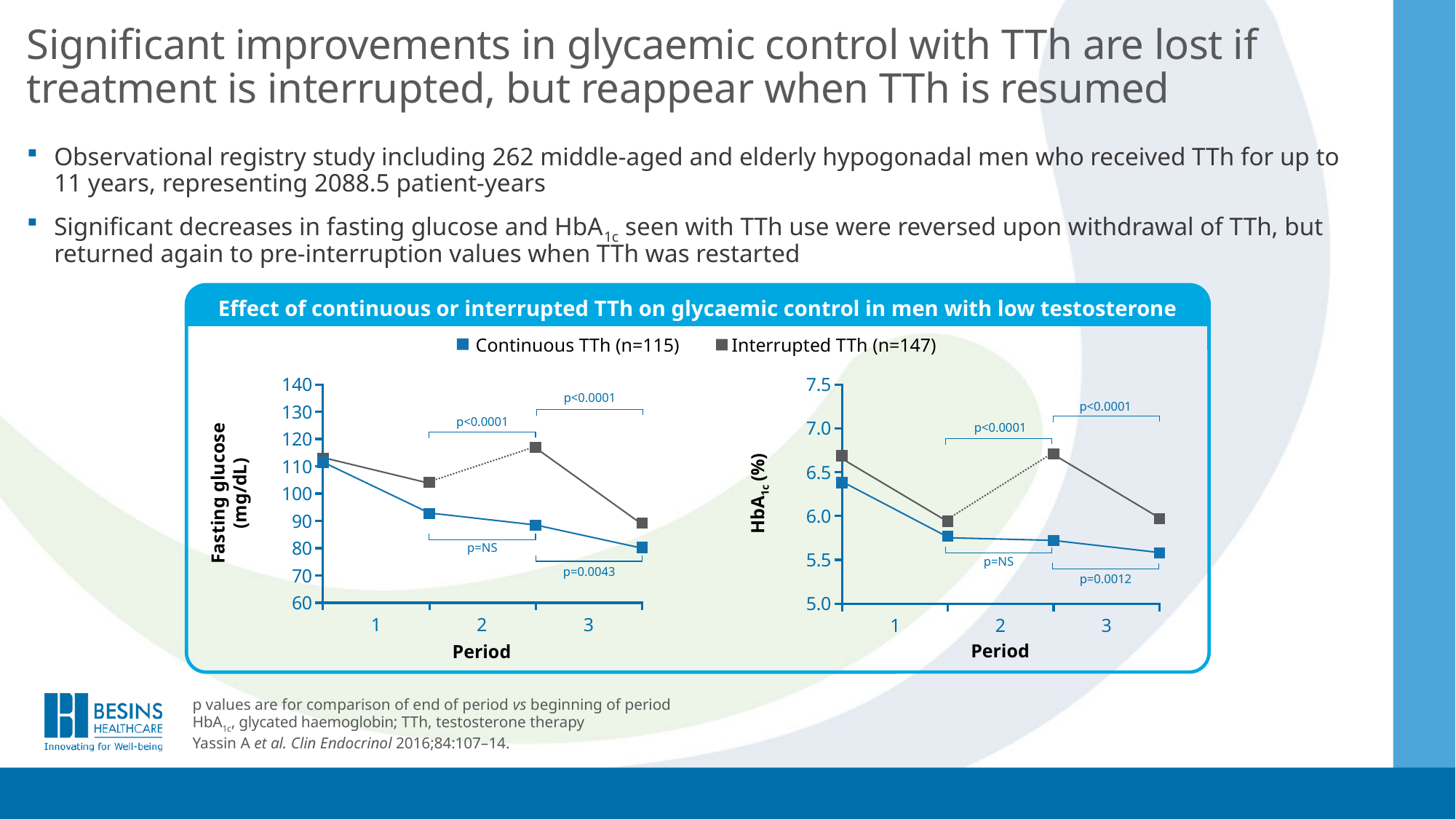
In the Fasting glucose chart, how many data points are plotted for the Continuous TTh series? 4 How many series does the legend list for the charts? 2 In the Fasting glucose chart, is the Continuous TTh value at the end of period 3 greater or less than 90? less In the Fasting glucose chart, does the Continuous TTh series rise or fall across the periods? Fall In the Fasting glucose chart, which series has the higher value at the end of period 2? Interrupted TTh (n=147) In the Fasting glucose chart, at which point is the Continuous TTh series lowest? End of period 3 In the Fasting glucose chart, is the Interrupted TTh value at the end of period 2 greater or less than 110? greater What kind of chart is the Fasting glucose chart on the left? Line chart In the Fasting glucose chart, what p value is shown for the Continuous TTh series in period 3? p=0.0043 In the HbA1c chart, is the Interrupted TTh value at the end of period 2 greater or less than 6.5? greater In the HbA1c chart, which series has the higher value at the end of period 3? Interrupted TTh (n=147)